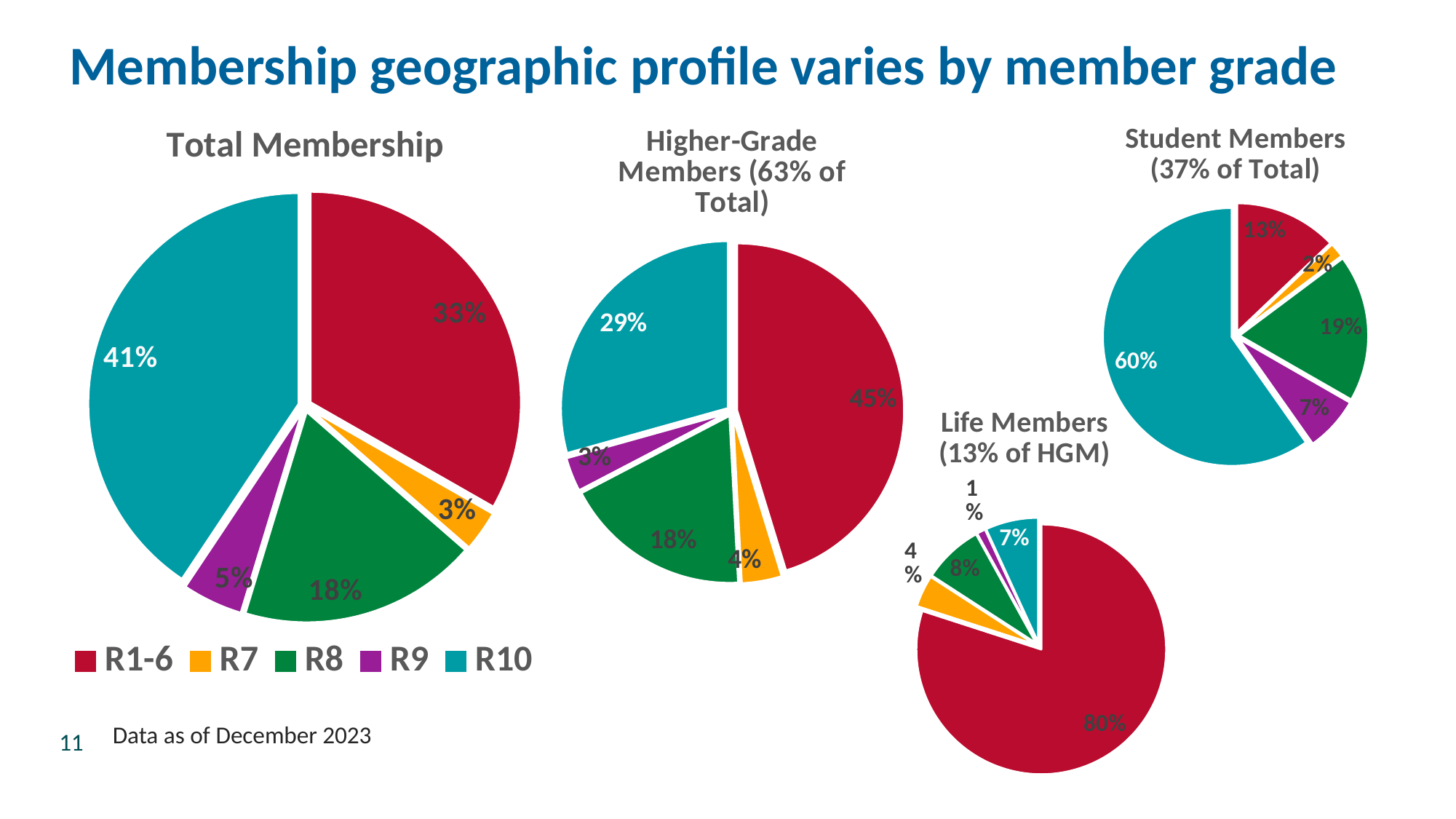
In the Life Members pie chart, what is the difference between the R1-6 share and the R8 share? 72% In the Student Members pie chart, what is the value for R8? 19% In the Student Members pie chart, which region has the largest share? R10 In the Total Membership pie chart, which is larger, the share for R8 or the share for R9? R8 In the Higher-Grade Members pie chart, what is the value for R1-6? 45% How many series does the legend list? 5 In the Higher-Grade Members pie chart, which region has the smallest share? R9 In the Total Membership pie chart, what is the value for R1-6? 33% In the Life Members pie chart, what is the value for R1-6? 80% How many pie charts are shown on the slide? 4 What kind of chart is the Total Membership chart? Pie chart In the Total Membership pie chart, what share does R10 have? 41%